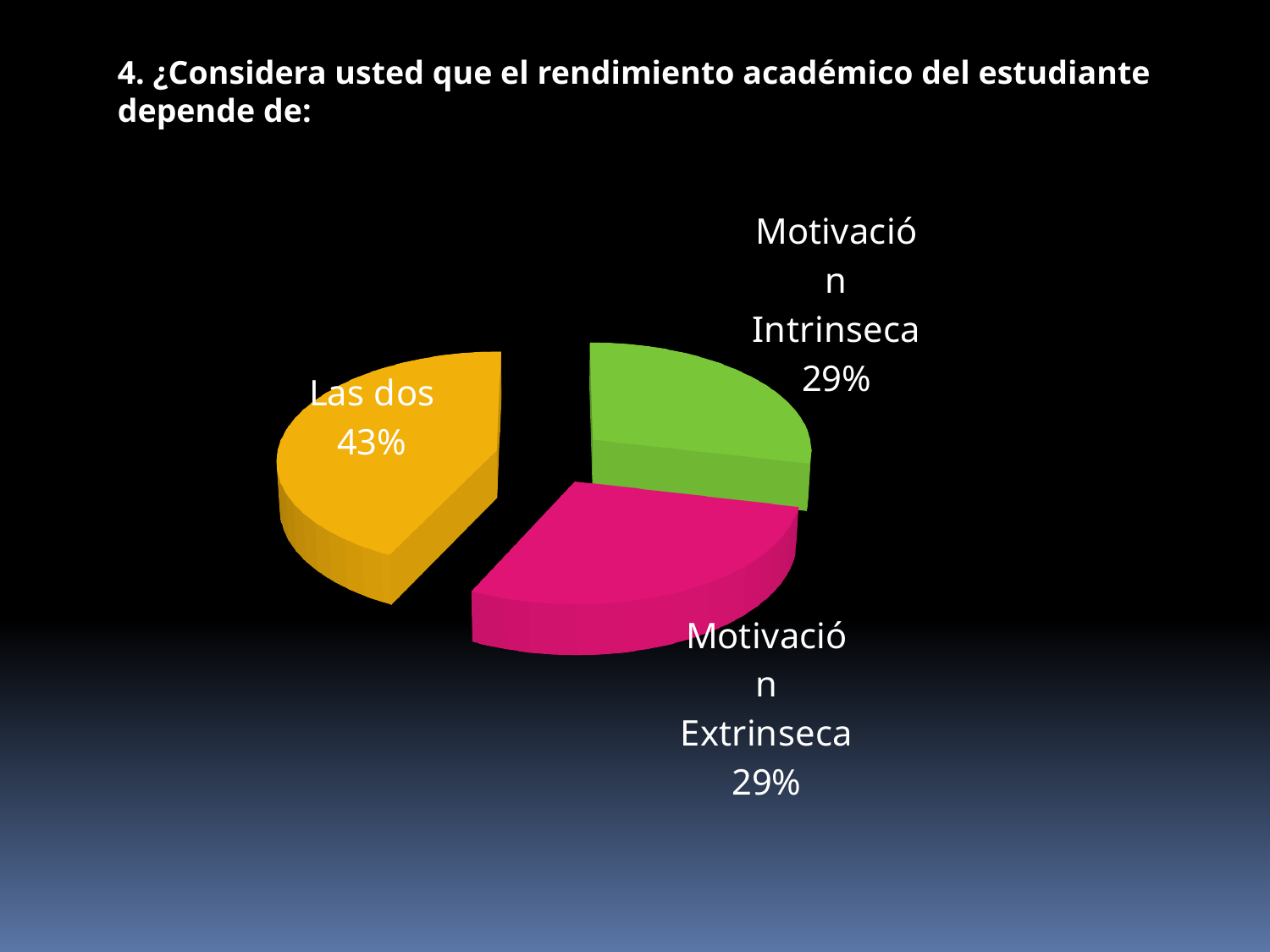
What percentage is shown for "Motivación Intrinseca"? 29% How many slices does the pie chart have? 3 What colour is the "Las dos" slice? Yellow/orange What is the difference in percentage points between "Las dos" and "Motivación Intrinseca"? 14 Which is larger, the share for "Las dos" or the share for "Motivación Extrinseca"? Las dos What percentage is shown for "Las dos"? 43% What kind of chart is shown on the slide? Pie chart What colour is the "Motivación Intrinseca" slice? Green Which category has the largest share of the pie? Las dos Do "Motivación Intrinseca" and "Motivación Extrinseca" have the same percentage? Yes What percentage is shown for "Motivación Extrinseca"? 29%